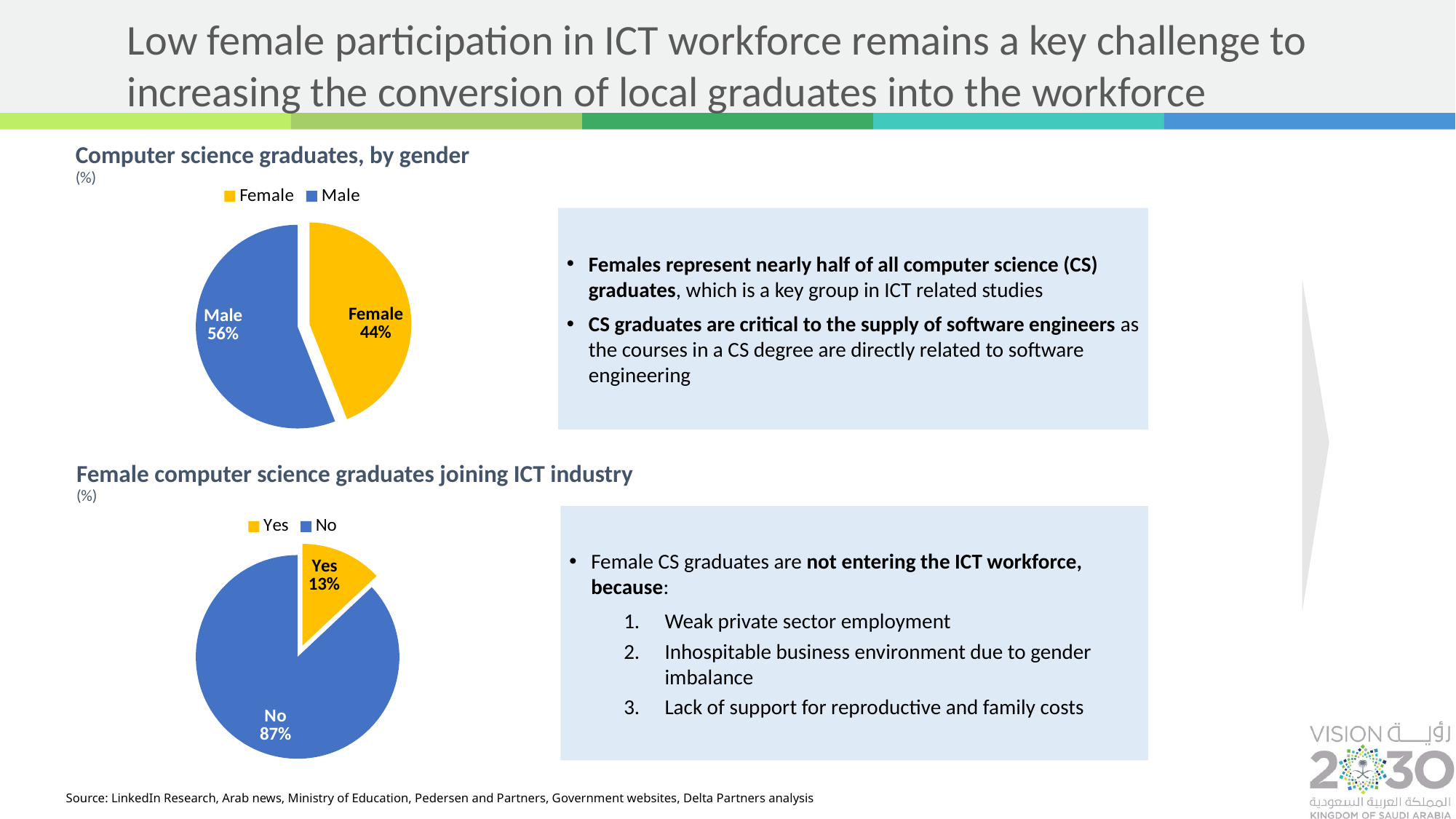
In the 'Computer science graduates, by gender' chart, what percentage of graduates are female? 44% In the 'Female computer science graduates joining ICT industry' chart, what percentage answered No? 87% In the 'Female computer science graduates joining ICT industry' chart, what colour is the 'No' slice? Blue In the 'Female computer science graduates joining ICT industry' chart, what percentage answered Yes? 13% In the 'Female computer science graduates joining ICT industry' chart, how many slices does the pie have? 2 In the 'Female computer science graduates joining ICT industry' chart, what is the difference between the No and Yes shares? 74% In the 'Computer science graduates, by gender' chart, what percentage of graduates are male? 56% What type of chart is the 'Computer science graduates, by gender' chart? Pie chart How many series does the legend of the 'Computer science graduates, by gender' chart list? 2 In the 'Computer science graduates, by gender' chart, what is the difference between the male and female shares? 12% In the 'Female computer science graduates joining ICT industry' chart, which slice is the smallest? Yes In the 'Computer science graduates, by gender' chart, which gender has the larger share? Male